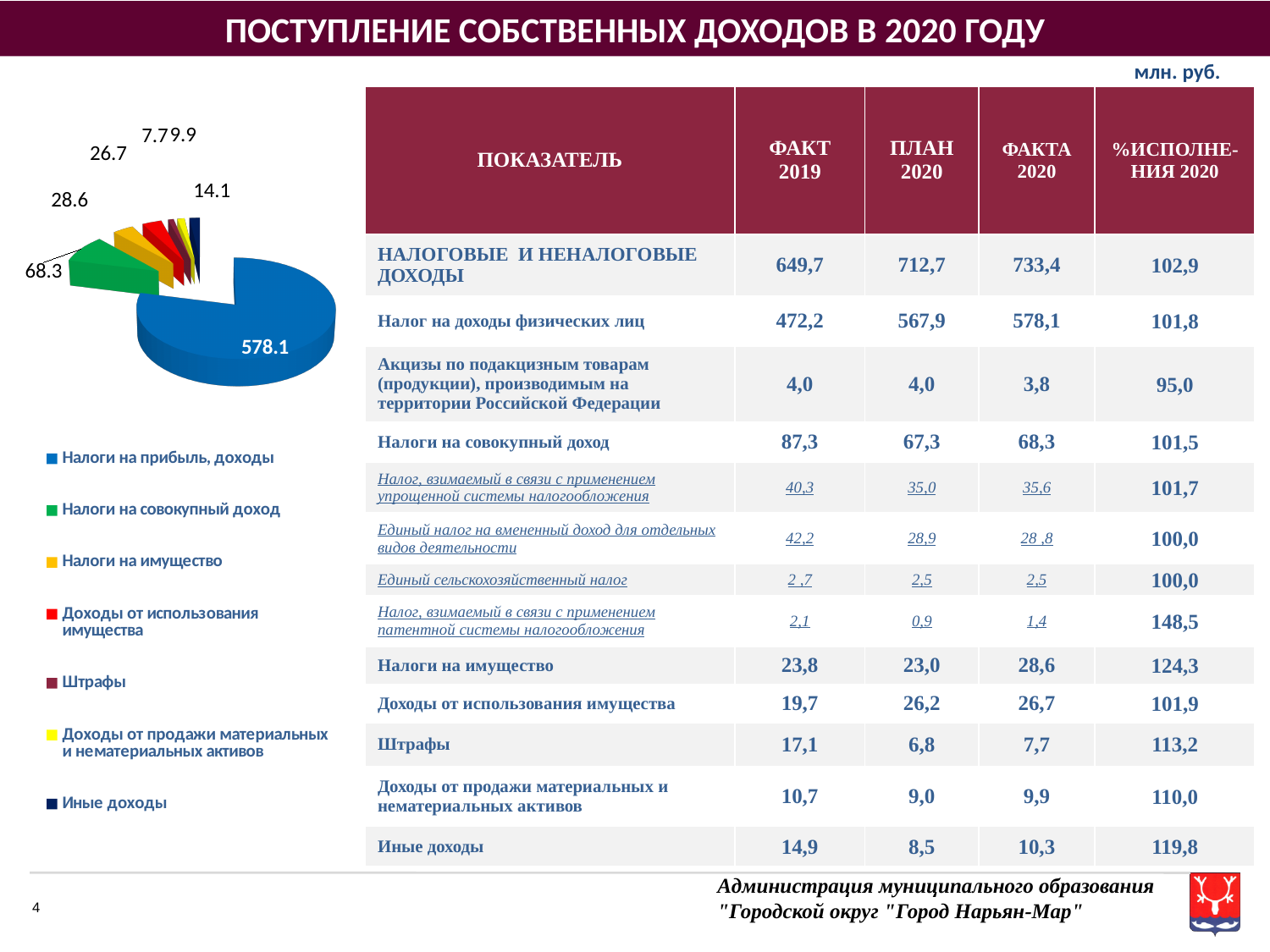
How many categories does the pie chart legend list? 7 What is the value for Налоги на прибыль, доходы in the pie chart? 578.1 What kind of chart is shown on the slide? pie chart Which is larger in the pie chart: Налоги на совокупный доход or Доходы от использования имущества? Налоги на совокупный доход What is the value for Налоги на совокупный доход in the pie chart? 68.3 What is the difference between the values for Налоги на прибыль, доходы and Налоги на совокупный доход in the pie chart? 509.8 What colour is the slice for Налоги на прибыль, доходы in the pie chart? blue What is the value for Доходы от использования имущества in the pie chart? 26.7 What is the value for Налоги на имущество in the pie chart? 28.6 What is the difference between the values for Налоги на совокупный доход and Налоги на имущество in the pie chart? 39.7 What is the last entry in the pie chart legend? Иные доходы Which category has the largest slice in the pie chart? Налоги на прибыль, доходы